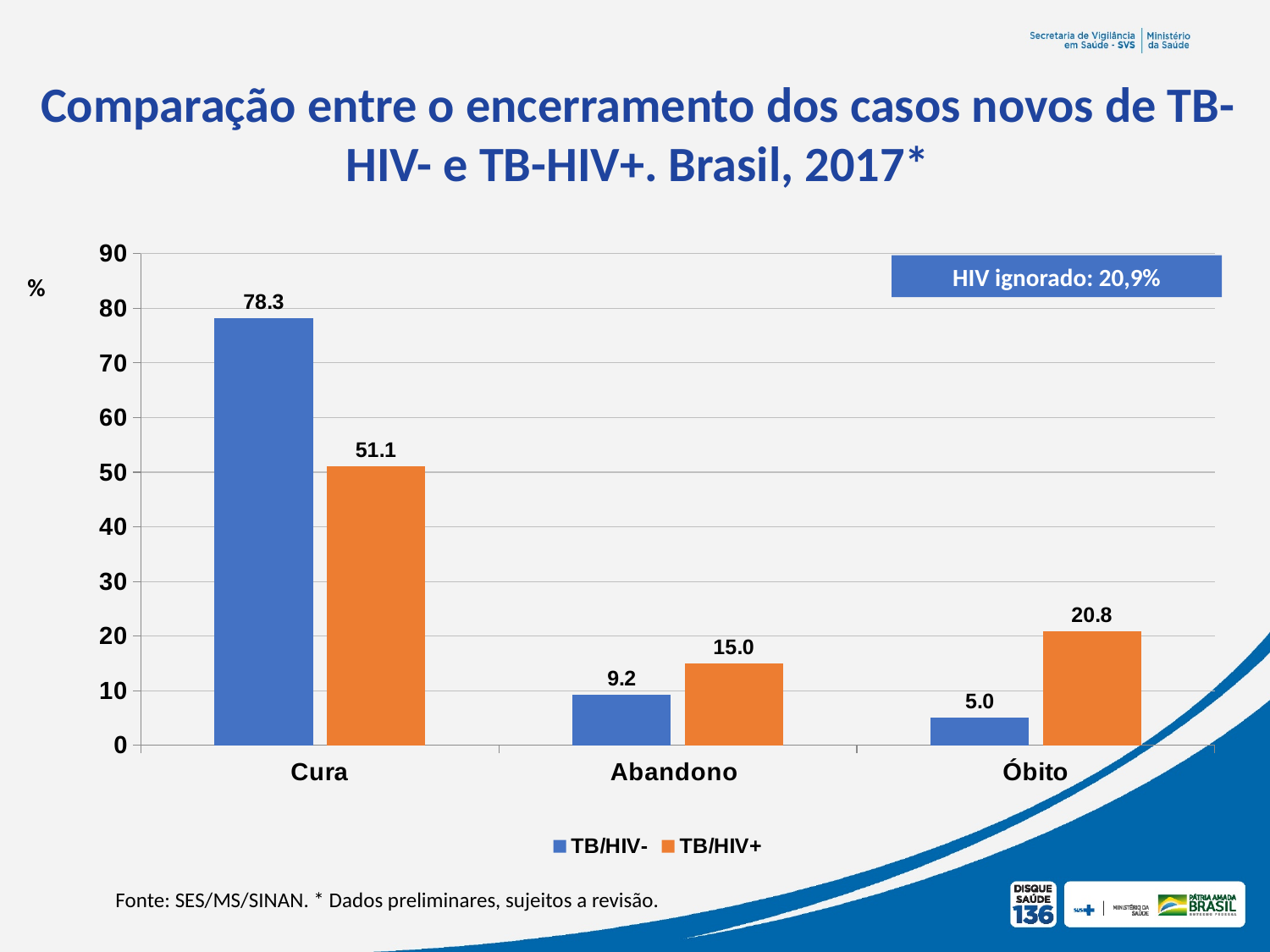
What kind of chart is shown on the slide? bar chart What percentage of HIV ignorado is stated in the box on the chart? 20,9% Is the value for TB/HIV+ in the Cura category greater or less than 60? less Which category has the highest value for the TB/HIV- series? Cura Which category has the lowest value for the TB/HIV+ series? Abandono Which series has the larger value in the Óbito category, TB/HIV- or TB/HIV+? TB/HIV+ What is the difference between the TB/HIV- and TB/HIV+ values in the Cura category? 27.2 What is the value for TB/HIV- in the Cura category? 78.3 What is the value for TB/HIV+ in the Abandono category? 15.0 What is the value for TB/HIV+ in the Óbito category? 20.8 How many series does the legend list? 2 How many categories are shown on the x axis? 3